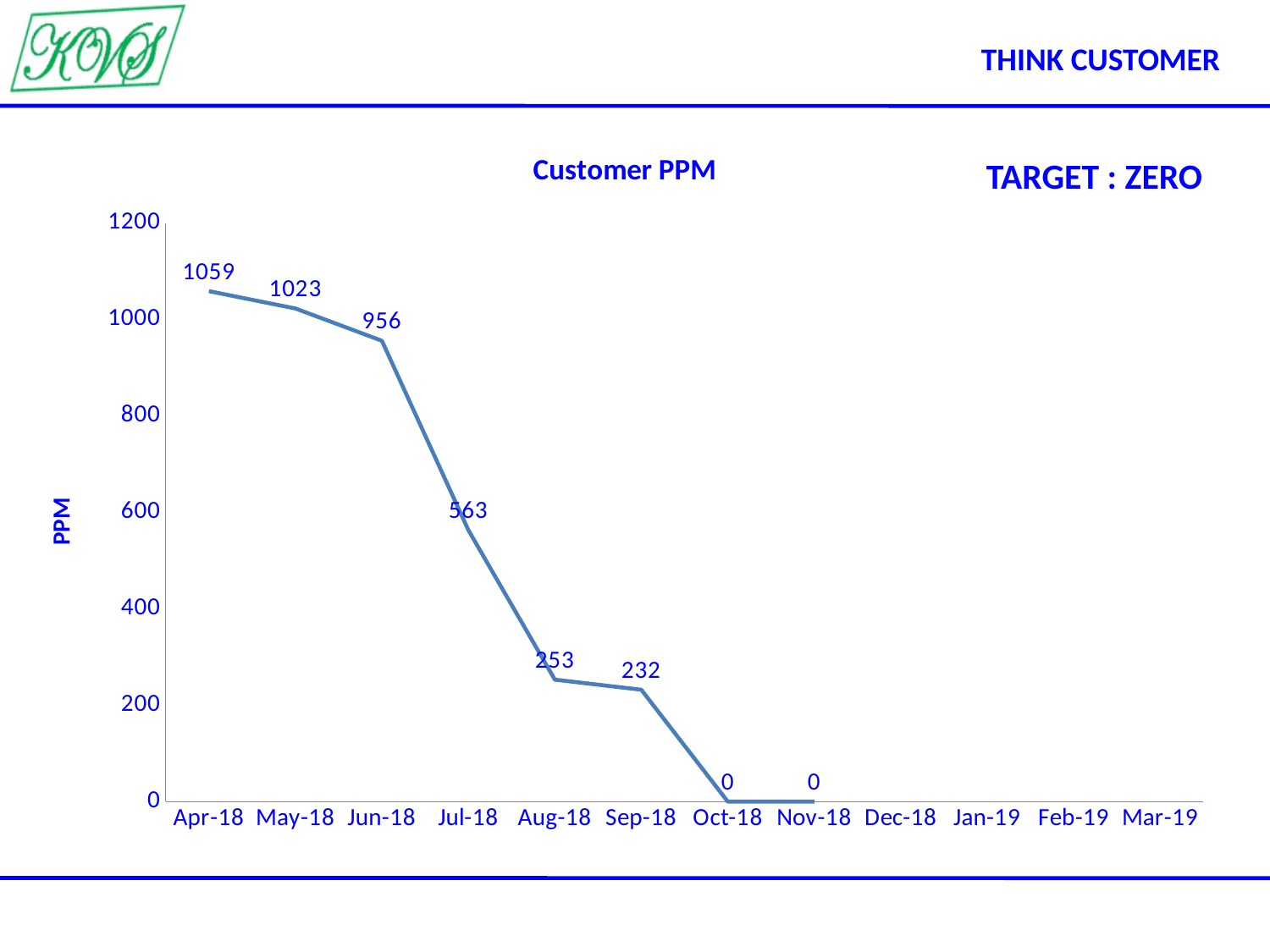
What is the Customer PPM value for Jul-18? 563 What is the Customer PPM value for Sep-18? 232 Which is larger, the Customer PPM for Aug-18 or for Sep-18? Aug-18 Which month has the highest Customer PPM value? Apr-18 What is the difference in Customer PPM between Jun-18 and Jul-18? 393 What is the difference in Customer PPM between Apr-18 and May-18? 36 What is the Customer PPM value for Apr-18? 1059 What is the Customer PPM value for Nov-18? 0 How many months have a plotted Customer PPM value? 8 Do the Customer PPM values rise or fall from Apr-18 to Nov-18? fall What kind of chart is the Customer PPM chart? line chart Is the Customer PPM value for Jun-18 greater or less than 1000? less